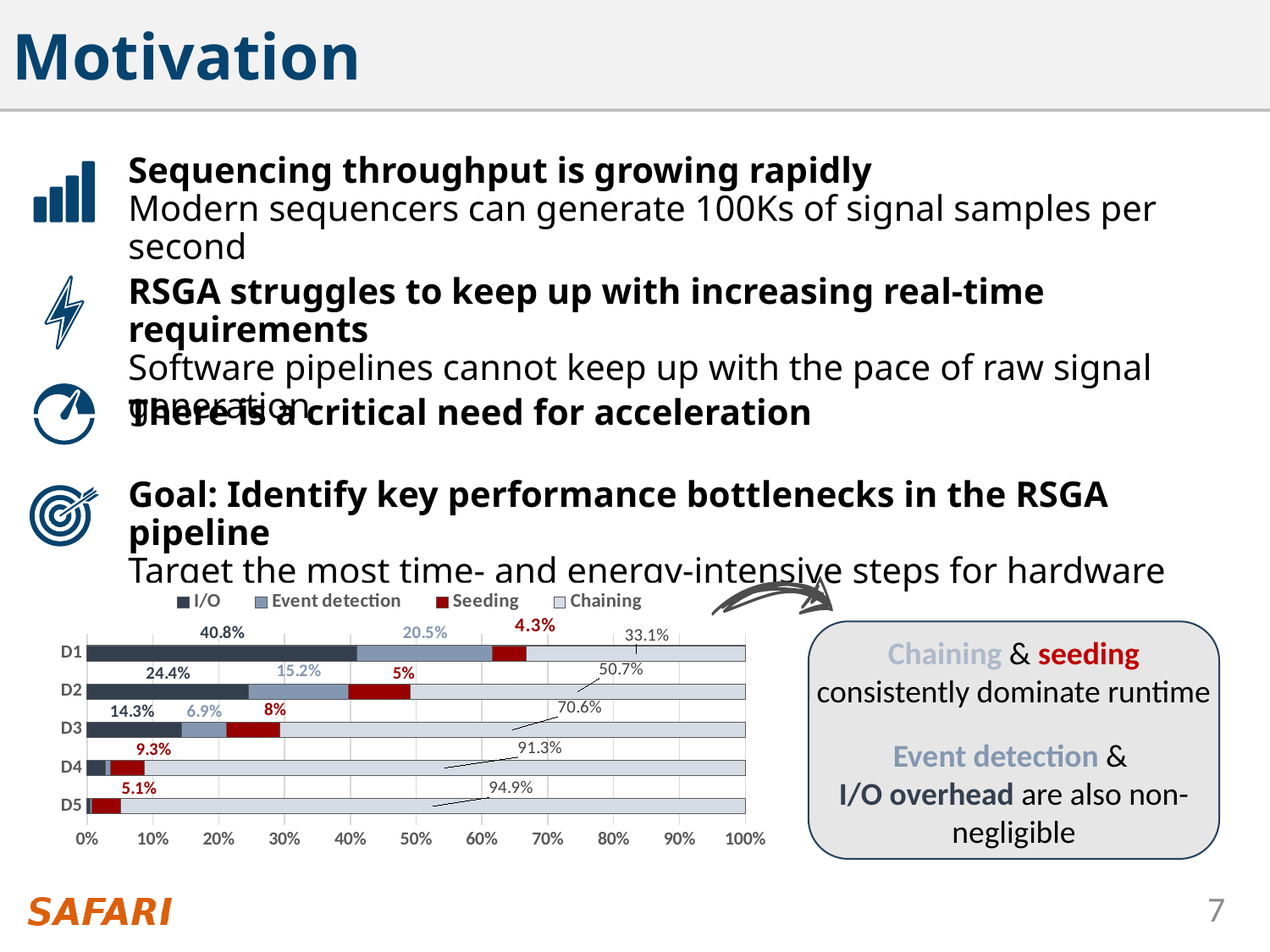
Which dataset has the lowest I/O share among those with a printed I/O label (D1, D2, D3)? D3 What is the I/O share for D1? 40.8% Which is larger for D1: the I/O share or the Chaining share? I/O Which dataset has the highest Chaining share? D5 Does the Chaining share rise or fall going from D1 down to D5? rise What is the Seeding share for D4? 9.3% What is the difference between the Chaining share of D2 and the Chaining share of D1? 17.6% What is the Chaining share for D3? 70.6% How many series does the chart legend list? 4 How many categories (datasets) are plotted on the y axis of the chart? 5 What kind of chart is shown on the slide? stacked bar chart What is the Event detection share for D2? 15.2%